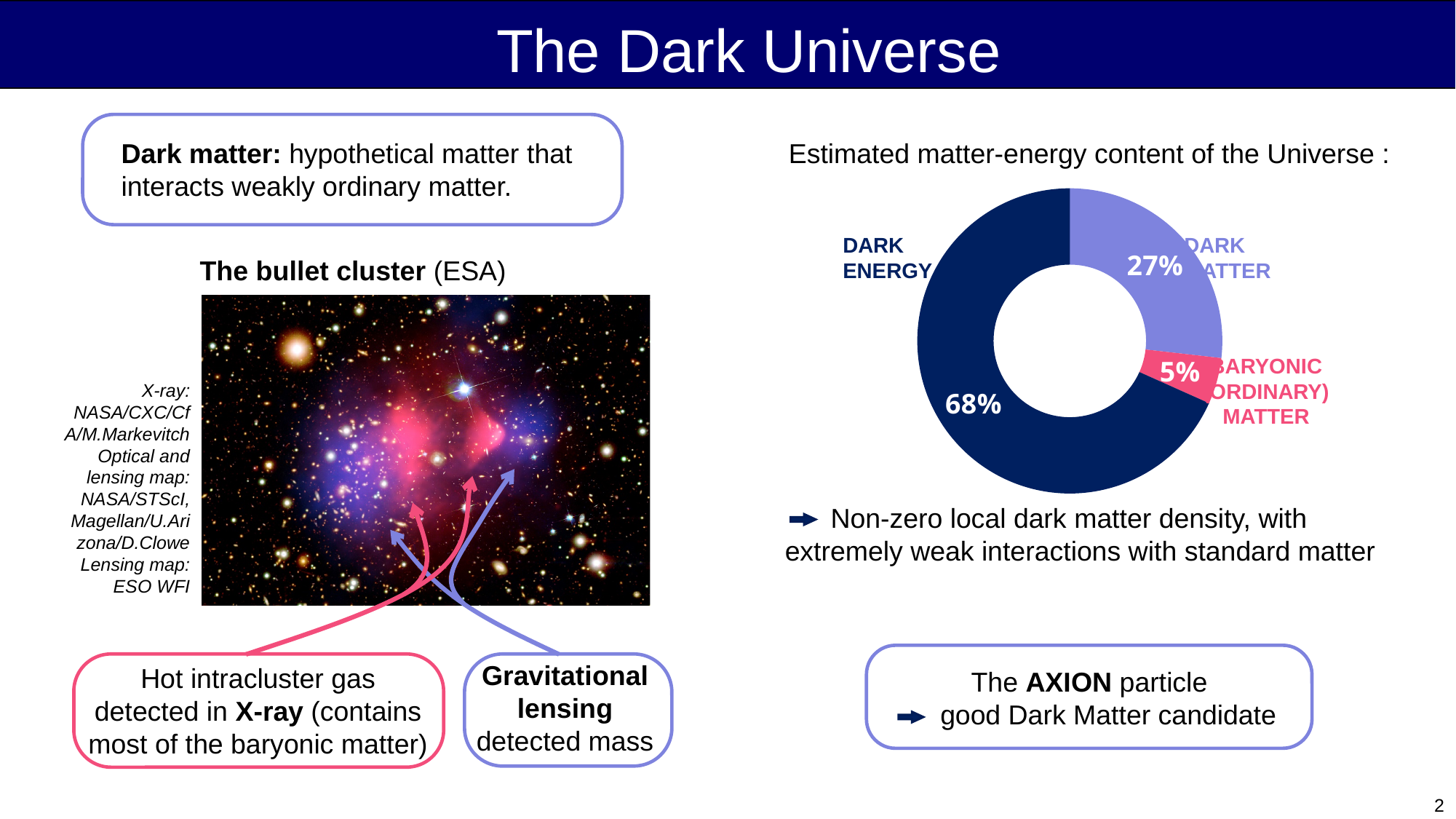
What share of the Universe's matter-energy content is dark energy according to the donut chart? 68% Which component has the smallest share in the donut chart? Baryonic (ordinary) matter Which component has the largest share in the donut chart? Dark energy What colour is the baryonic (ordinary) matter segment in the donut chart? Pink What share of the Universe's matter-energy content is baryonic (ordinary) matter according to the donut chart? 5% How many segments does the donut chart have? 3 By how many percentage points does dark matter exceed baryonic matter in the donut chart? 22 What kind of chart shows the estimated matter-energy content of the Universe? Donut (pie) chart By how many percentage points does dark energy exceed dark matter in the donut chart? 41 What share of the Universe's matter-energy content is dark matter according to the donut chart? 27% What is the combined share of dark energy and dark matter in the donut chart? 95% Which is larger in the donut chart, dark matter or baryonic matter? Dark matter